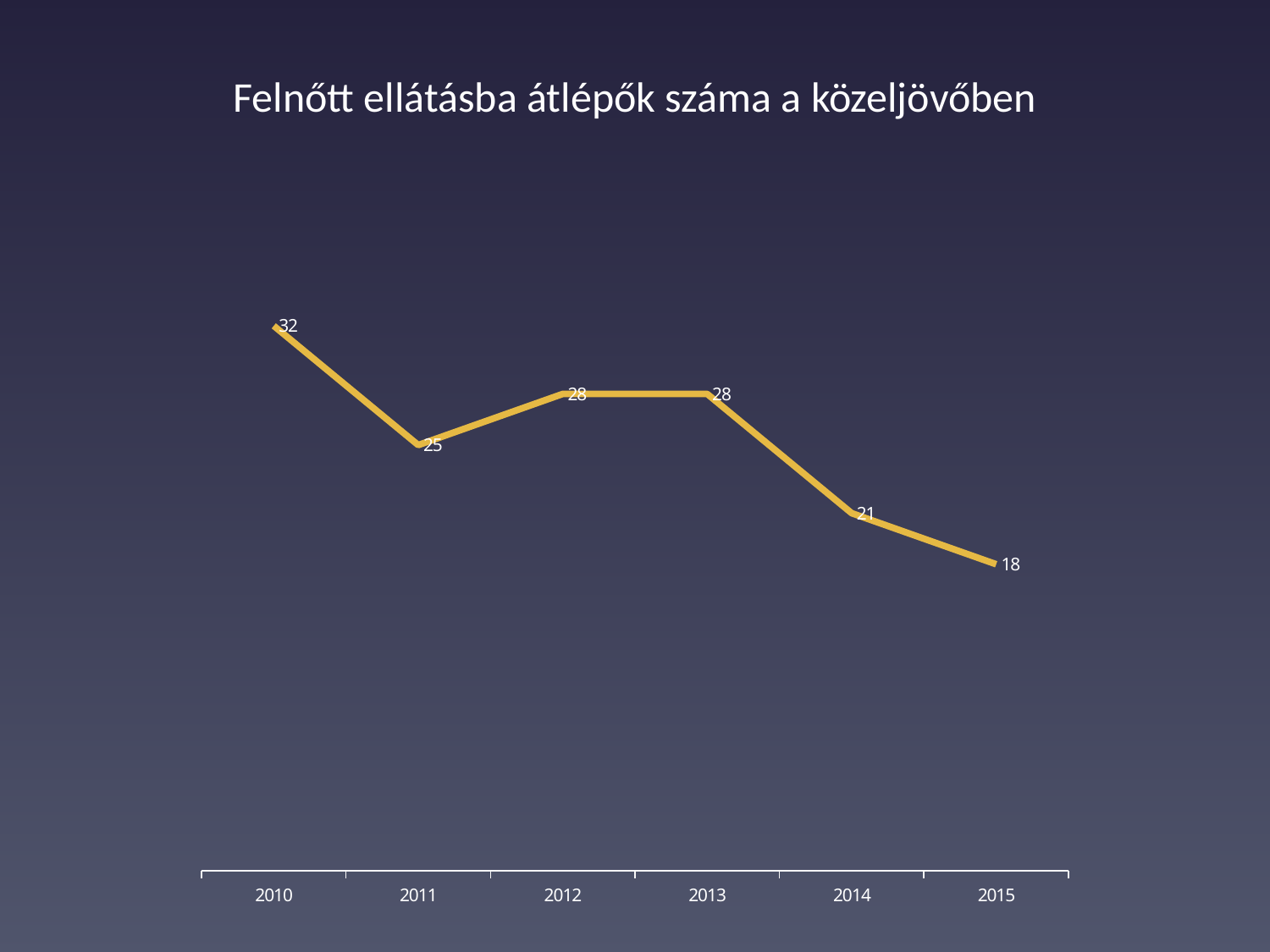
What kind of chart is shown on the slide? line chart Which year has the highest value? 2010 What is the title of the chart? Felnőtt ellátásba átlépők száma a közeljövőben Which is larger, the value for 2011 or the value for 2012? 2012 What is the difference between the values for 2010 and 2015? 14 Which year has the lowest value? 2015 What is the value for 2015? 18 What is the value for 2010? 32 What is the value for 2014? 21 What is the value for 2011? 25 How many years are plotted on the x axis? 6 What is the difference between the values for 2013 and 2014? 7